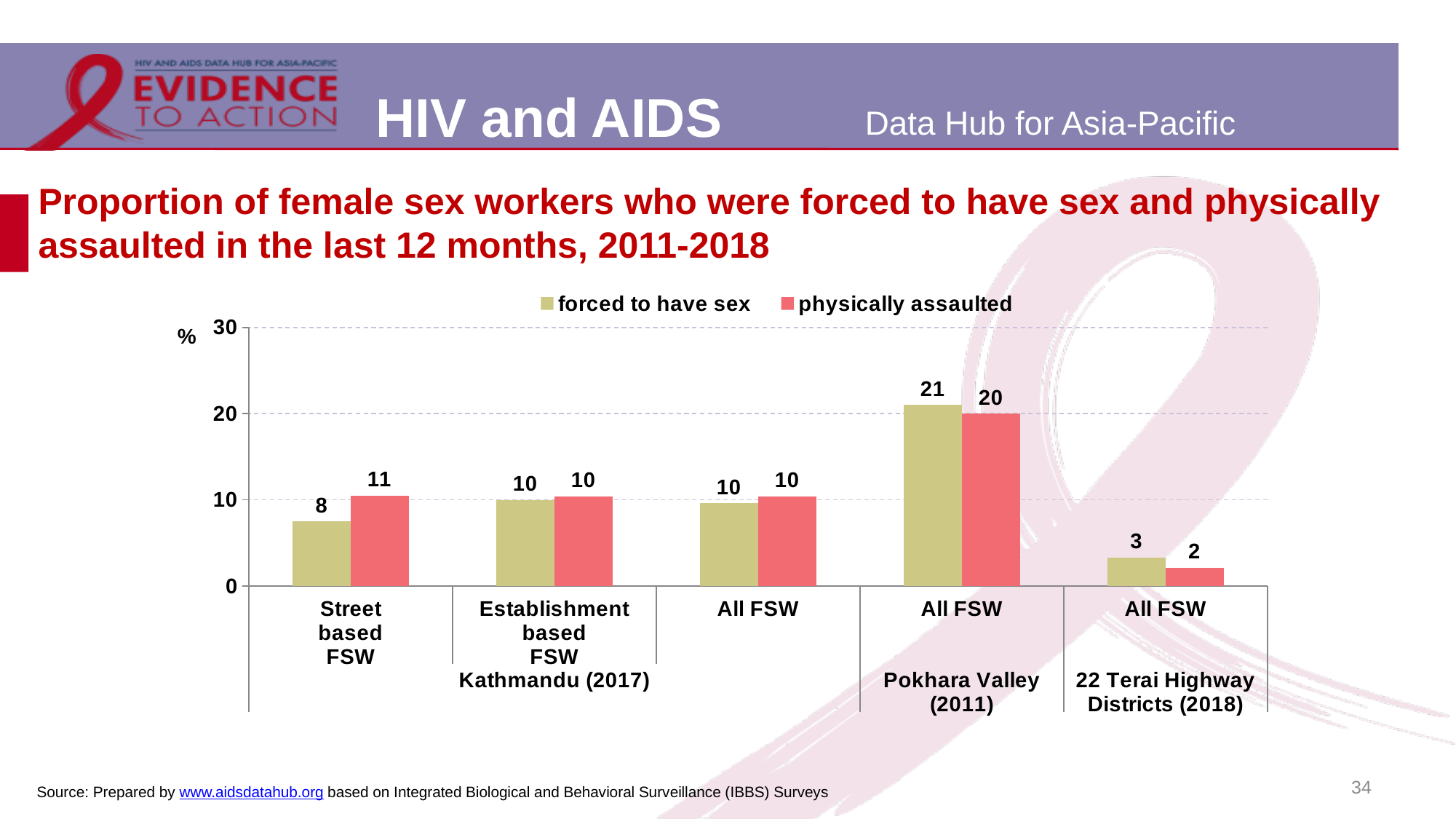
Which category group has the highest value for 'forced to have sex'? All FSW, Pokhara Valley (2011) What is the value for 'physically assaulted' among street based FSW in Kathmandu (2017)? 11 What is the value for 'forced to have sex' among all FSW in Pokhara Valley (2011)? 21 Which category group has the lowest value for 'physically assaulted'? All FSW, 22 Terai Highway Districts (2018) How many series does the legend list? 2 What is the value for 'forced to have sex' among street based FSW in Kathmandu (2017)? 8 For street based FSW in Kathmandu (2017), which is larger: 'forced to have sex' or 'physically assaulted'? physically assaulted How many category groups are plotted along the x axis? 5 What type of chart is shown on the slide? bar chart What is the difference between the 'forced to have sex' and 'physically assaulted' values for all FSW in Pokhara Valley (2011)? 1 What is the value for 'physically assaulted' among all FSW in the 22 Terai Highway Districts (2018)? 2 What unit is shown on the y axis? %